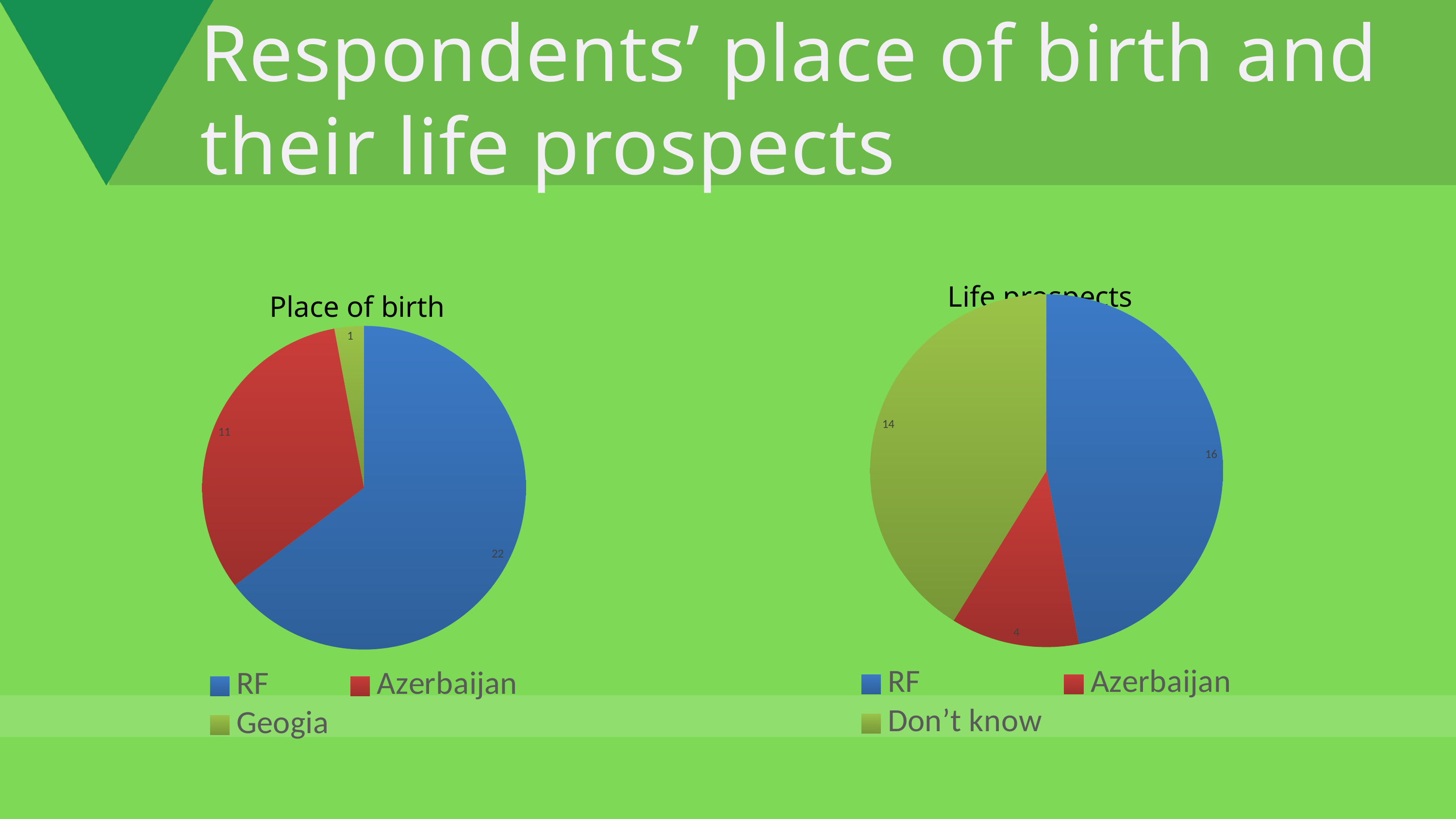
In the 'Place of birth' chart, which category has the smallest slice? Geogia In the 'Place of birth' chart, what is the value for Azerbaijan? 11 In the 'Life prospects' chart, what is the value for Don't know? 14 What kind of chart is the 'Life prospects' chart? Pie chart In the 'Life prospects' chart, which is larger, RF or Don't know? RF In the 'Life prospects' chart, what is the value for Azerbaijan? 4 In the 'Place of birth' chart, what is the difference between the values for RF and Azerbaijan? 11 How many slices does the 'Place of birth' chart have? 3 In the 'Life prospects' chart, which category has the largest slice? RF In the 'Place of birth' chart, what is the value for RF? 22 What are the legend entries of the 'Life prospects' chart? RF, Azerbaijan, Don't know In the 'Place of birth' chart, what is the value for Geogia? 1